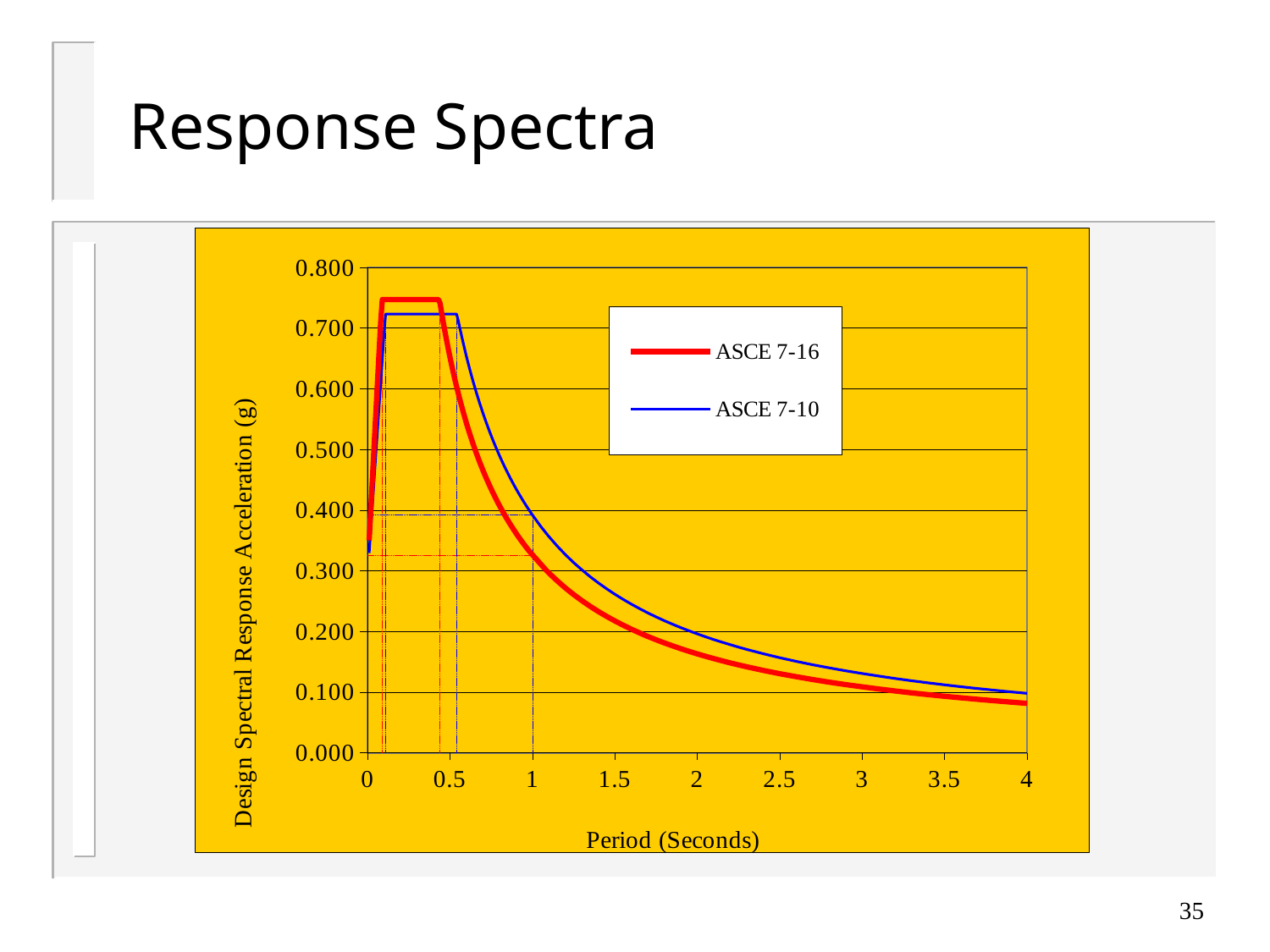
Do the values of both curves rise or fall as the period increases from 1 to 4 seconds? fall Is the value of the ASCE 7-16 curve at a period of 1 second greater or less than 0.400? less Which series is drawn in red? ASCE 7-16 How many series does the legend list? 2 Is the value of the ASCE 7-10 curve at a period of 3 seconds greater or less than 0.100? greater Is the value of the ASCE 7-10 curve at a period of 1.5 seconds greater or less than 0.200? greater What kind of chart is shown on the slide? line chart What is the label of the x axis? Period (Seconds) At a period of 2 seconds, which series has the higher value, ASCE 7-16 or ASCE 7-10? ASCE 7-10 Which series reaches the higher peak value, ASCE 7-16 or ASCE 7-10? ASCE 7-16